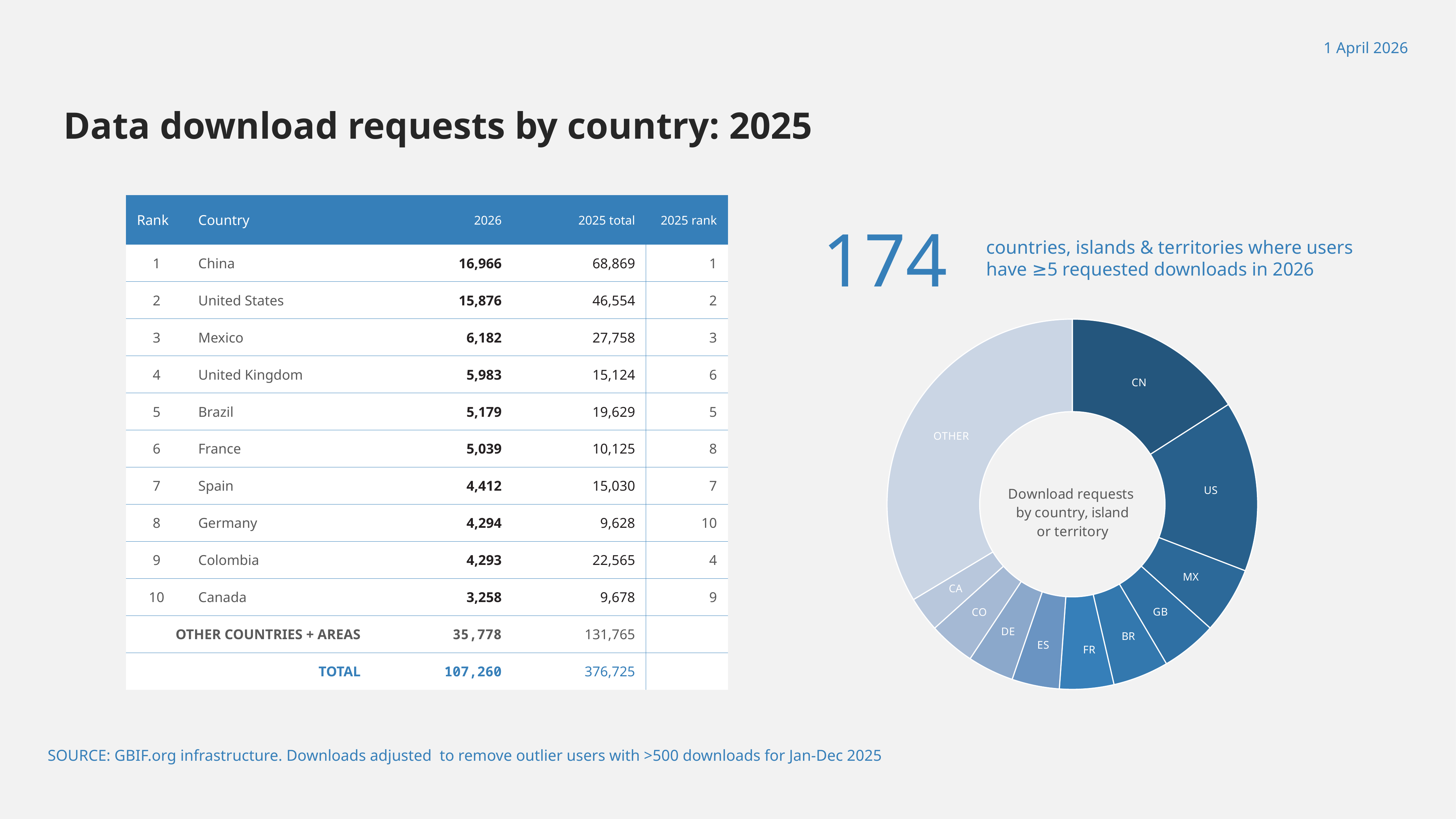
How many slices does the pie chart have? 11 In the pie chart, which slice is larger, GB or DE? GB In the pie chart, which slice is larger, MX or CA? MX Excluding the OTHER slice, which country slice of the pie chart is the largest? CN In the pie chart, which slice is larger, CN or MX? CN Which slice of the pie chart is the largest? OTHER Which slice of the pie chart is the smallest? CA What kind of chart is shown on the right of the slide? doughnut chart What text is written in the centre of the pie chart? Download requests by country, island or territory Which slice of the pie chart is shaded the lightest blue? OTHER